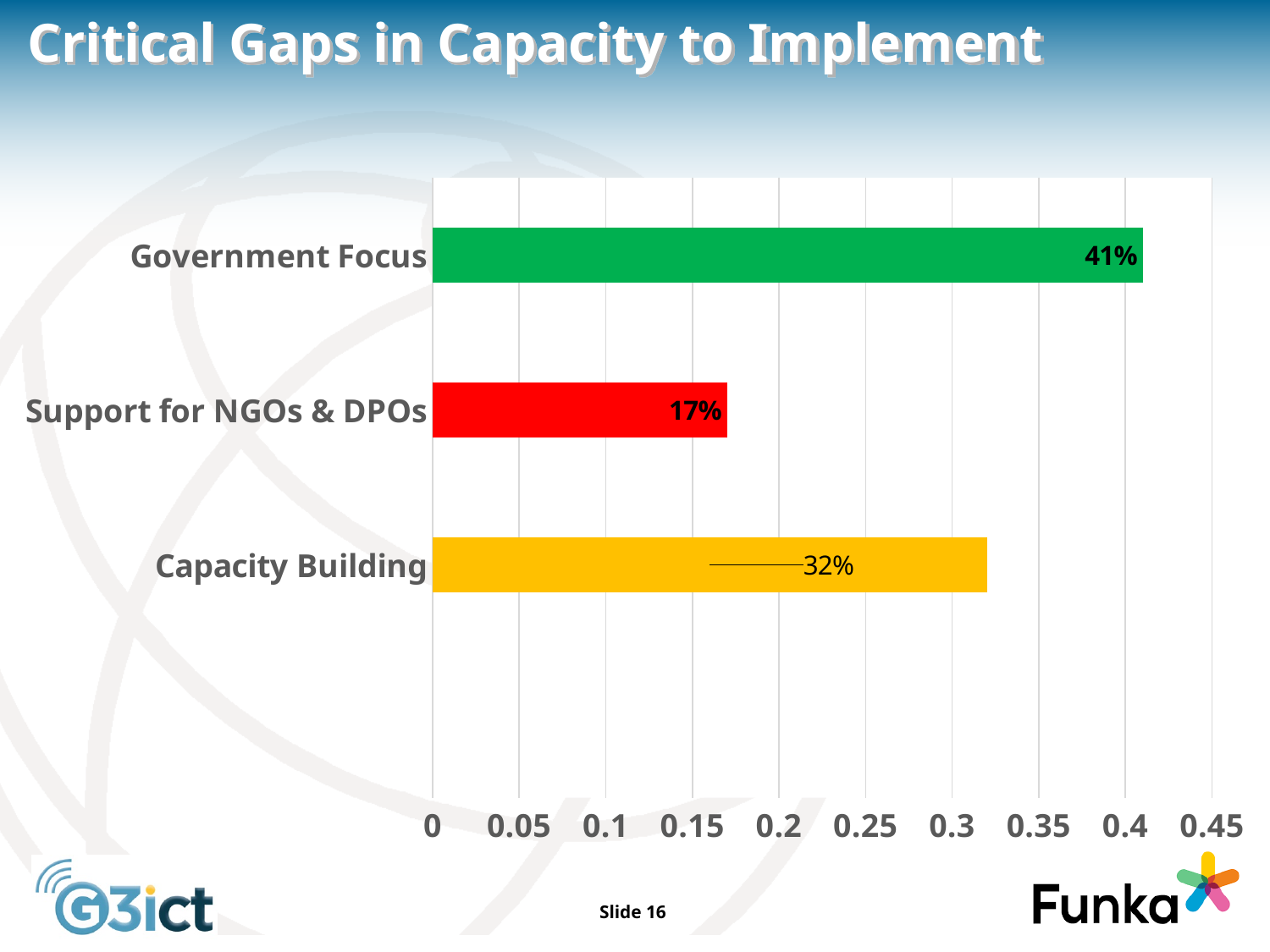
What is the difference between the values for Capacity Building and Support for NGOs & DPOs? 15% Which is larger, the value for Capacity Building or the value for Support for NGOs & DPOs? Capacity Building What is the value for Government Focus? 41% What is the value for Capacity Building? 32% What is the title of the slide containing the chart? Critical Gaps in Capacity to Implement What kind of chart is shown on the slide? bar chart What is the difference between the values for Government Focus and Capacity Building? 9% Which category has the highest value? Government Focus Which category has the lowest value? Support for NGOs & DPOs Is the value for Government Focus greater or less than 0.4? greater How many categories are shown in the chart? 3 What is the value for Support for NGOs & DPOs? 17%